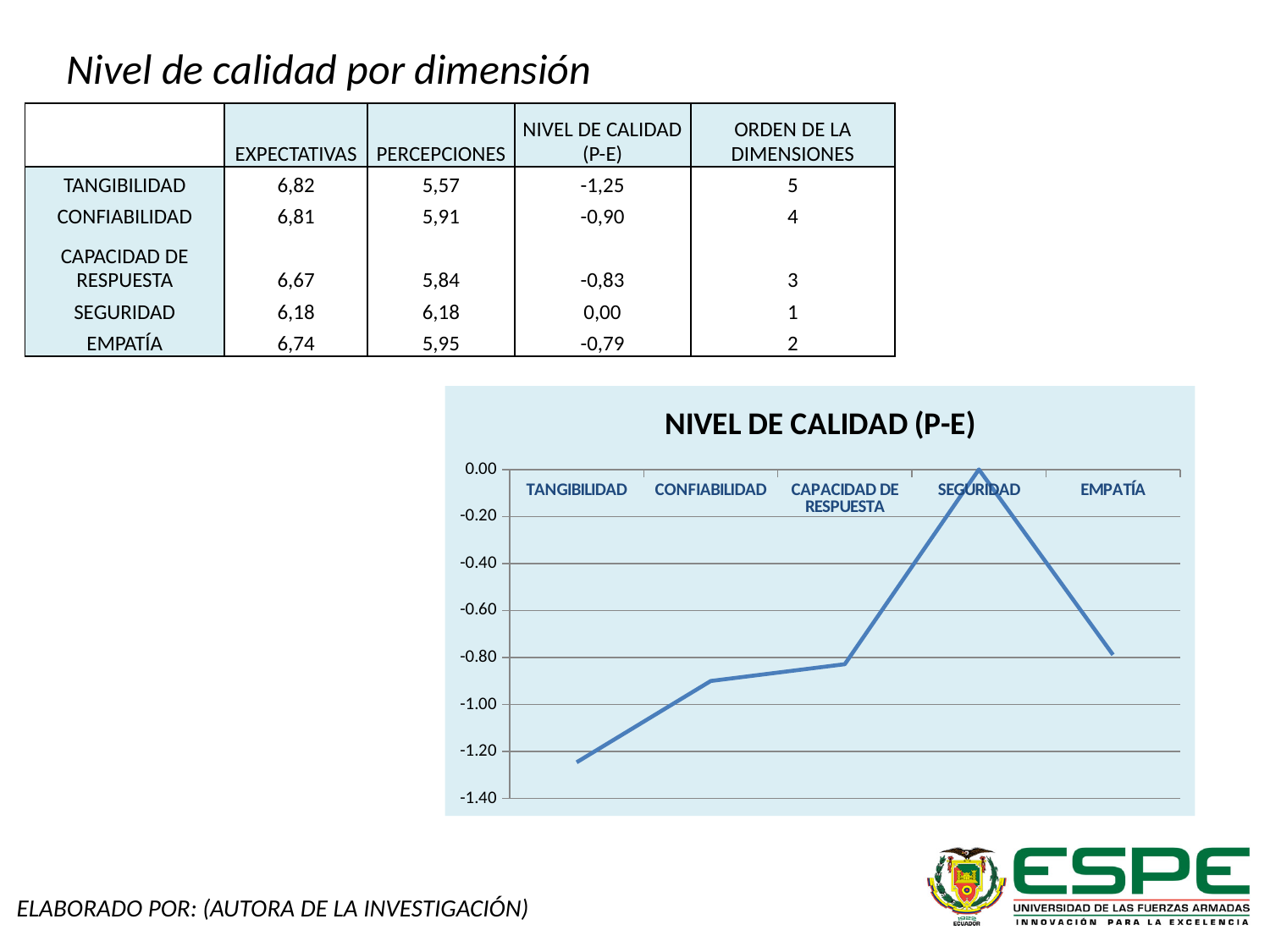
Is the value for EMPATÍA greater or less than -0.60? less Which has the larger value, TANGIBILIDAD or EMPATÍA? EMPATÍA How many dimensions are plotted along the x axis of the chart? 5 Does the line rise or fall from TANGIBILIDAD to SEGURIDAD? rise What is the title of the chart? NIVEL DE CALIDAD (P-E) What value does the line reach for SEGURIDAD? 0.00 Which dimension has the highest value in the chart? SEGURIDAD Which dimension has the lowest value in the chart? TANGIBILIDAD What kind of chart is shown on the slide? line chart Is the value for TANGIBILIDAD greater or less than -1.20? less Is the value for CONFIABILIDAD greater or less than -1.00? greater According to the table, what is the NIVEL DE CALIDAD (P-E) for TANGIBILIDAD? -1,25